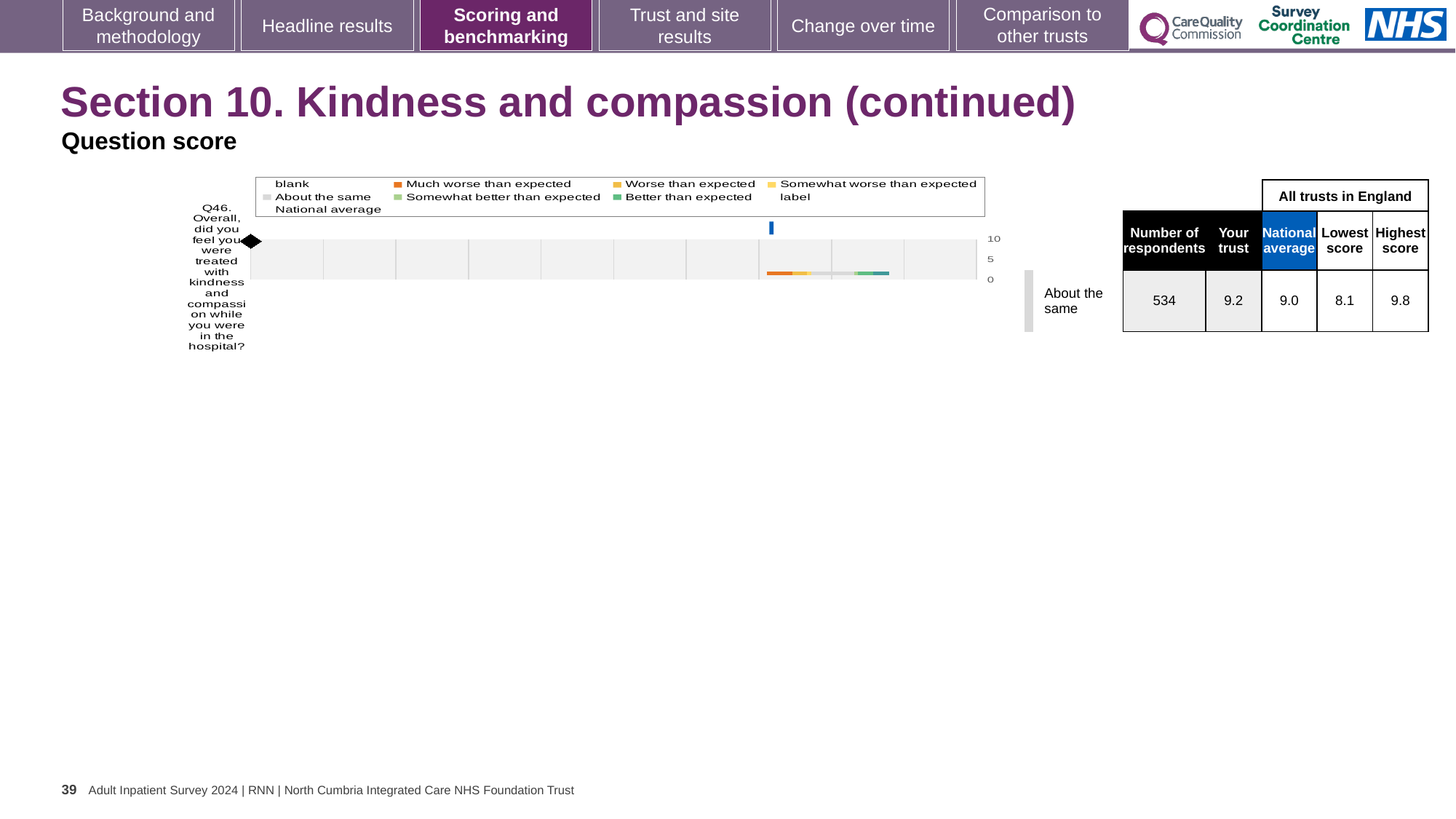
What colour does the legend use for "Much worse than expected"? orange Is the trust's score for Q46 higher or lower than the national average? higher How many questions are plotted on the chart? 1 Which benchmark category is the trust's Q46 score placed in? About the same What is the "Your trust" score for Q46 in the table beside the chart? 9.2 How many respondents answered Q46 according to the table beside the chart? 534 What is the highest score among all trusts in England for Q46? 9.8 What is the difference between the highest score and the lowest score for Q46? 1.7 What kind of chart is used to show the Q46 question score? bar chart What is the national average score for Q46 in the table beside the chart? 9.0 What is the lowest score among all trusts in England for Q46? 8.1